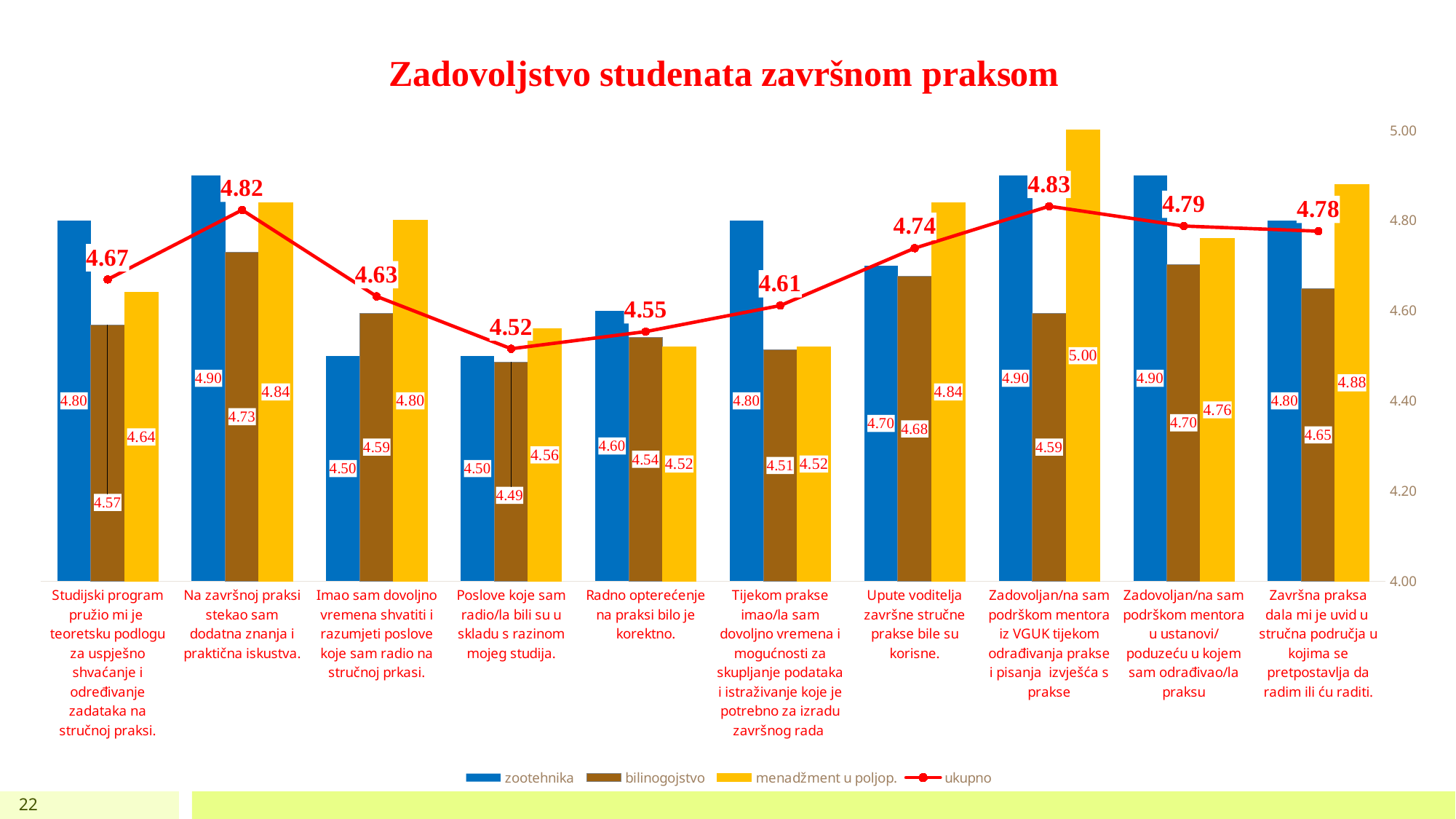
How many series does the legend list? 4 Is the zootehnika value for "Na završnoj praksi stekao sam dodatna znanja i praktična iskustva." greater or less than 4.80? greater What is the ukupno value for "Radno opterećenje na praksi bilo je korektno."? 4.55 Which category has the lowest ukupno value? Poslove koje sam radio/la bili su u skladu s razinom mojeg studija. What is the title of the chart? Zadovoljstvo studenata završnom praksom What is the bilinogojstvo value for "Na završnoj praksi stekao sam dodatna znanja i praktična iskustva."? 4.73 How many categories are shown on the x axis? 10 Which category has the highest ukupno value? Zadovoljan/na sam podrškom mentora iz VGUK tijekom odrađivanja prakse i pisanja izvješća s prakse What is the difference between the zootehnika and bilinogojstvo values for "Tijekom prakse imao/la sam dovoljno vremena i mogućnosti za skupljanje podataka i istraživanje koje je potrebno za izradu završnog rada"? 0.29 For "Imao sam dovoljno vremena shvatiti i razumjeti poslove koje sam radio na stručnoj prkasi.", which is larger: the zootehnika value or the menadžment u poljop. value? menadžment u poljop. What is the menadžment u poljop. value for "Zadovoljan/na sam podrškom mentora iz VGUK tijekom odrađivanja prakse i pisanja izvješća s prakse"? 5.00 What kind of chart is shown on the slide? Combined bar and line chart